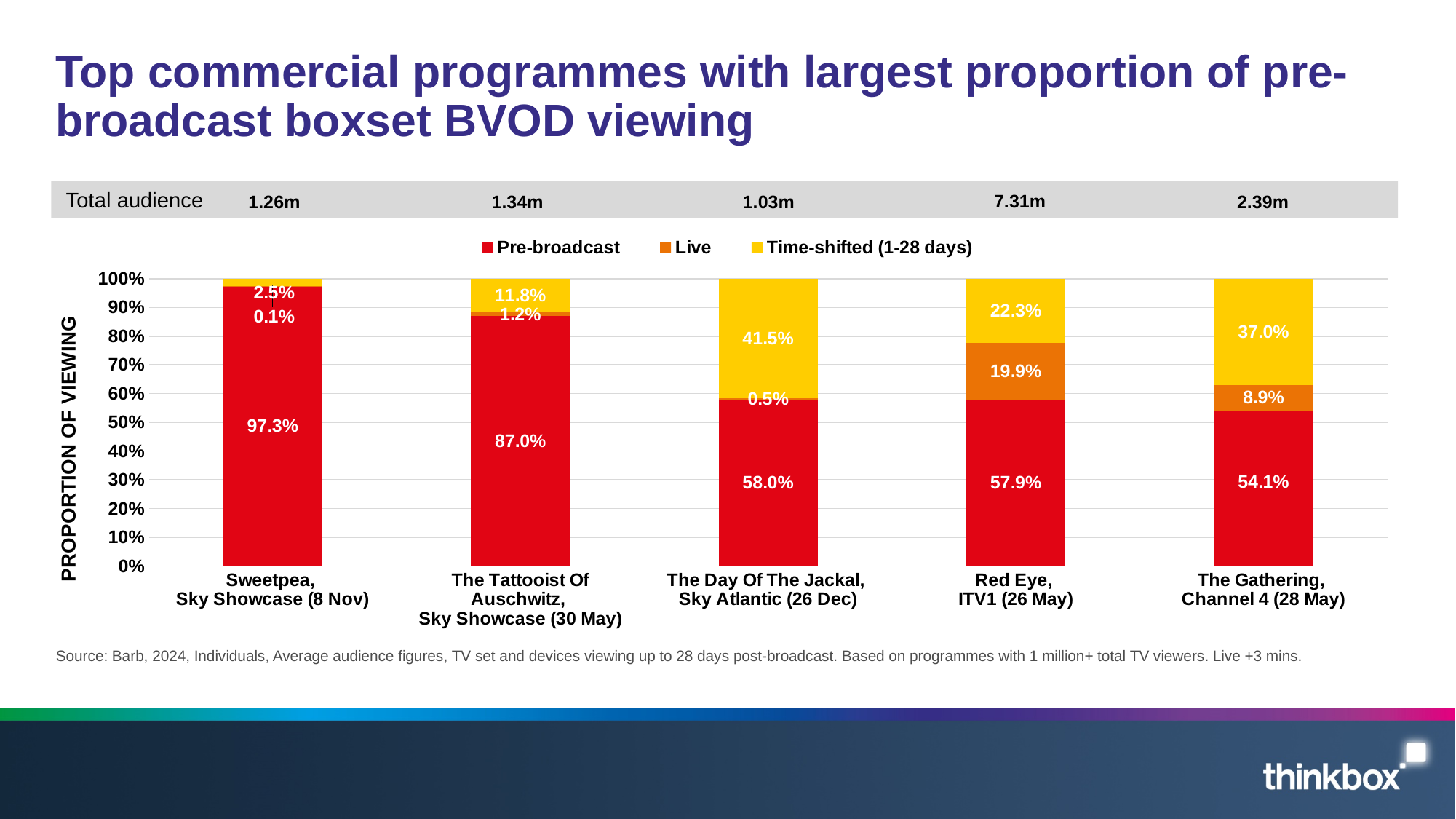
What is the Pre-broadcast value for The Gathering, Channel 4 (28 May)? 54.1% Which is larger: the Time-shifted (1-28 days) value for Red Eye or for The Gathering? The Gathering How many programmes are shown on the x axis? 5 What is the Time-shifted (1-28 days) value for The Day Of The Jackal, Sky Atlantic (26 Dec)? 41.5% How many series does the legend list? 3 What kind of chart is shown on the slide? Stacked bar chart What is the difference between the Pre-broadcast values for Sweetpea and The Tattooist Of Auschwitz? 10.3% What is the Live value for Red Eye, ITV1 (26 May)? 19.9% Which programme has the lowest Pre-broadcast proportion? The Gathering, Channel 4 (28 May) What is the total audience shown for Red Eye, ITV1 (26 May)? 7.31m What is the Pre-broadcast value for Sweetpea, Sky Showcase (8 Nov)? 97.3% Which programme has the highest Pre-broadcast proportion? Sweetpea, Sky Showcase (8 Nov)